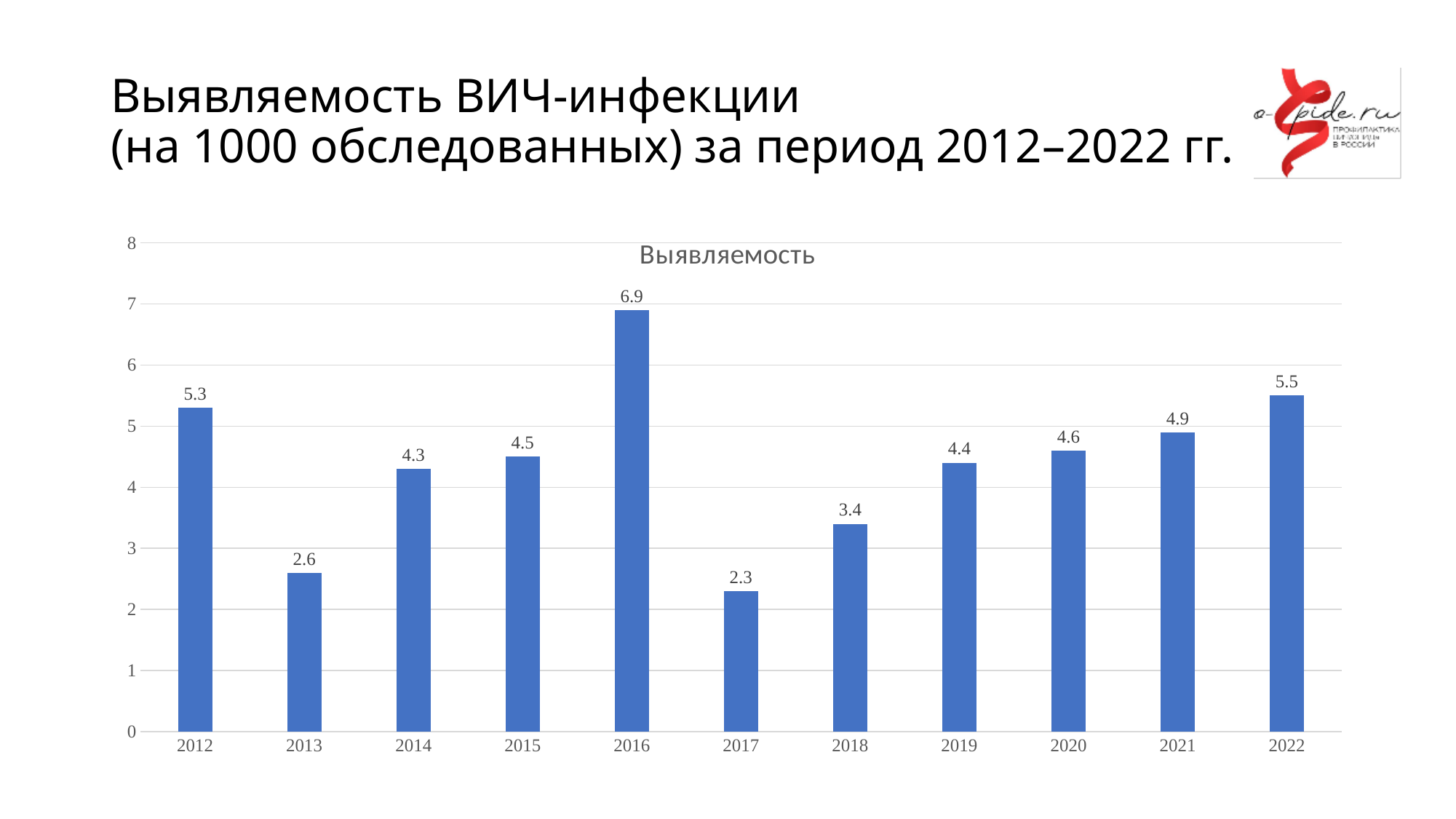
Is the value for 2018 greater or less than 4? less What is the value for 2013? 2.6 What is the difference between the values for 2016 and 2017? 4.6 What is the value for 2022? 5.5 What is the value for 2016? 6.9 How many years are shown on the x axis? 11 Do the values rise or fall from 2017 to 2022? rise What is the title of the chart? Выявляемость Which year has the lowest value? 2017 What kind of chart is shown? bar chart Which is larger, the value for 2012 or the value for 2022? 2022 Which year has the highest value? 2016